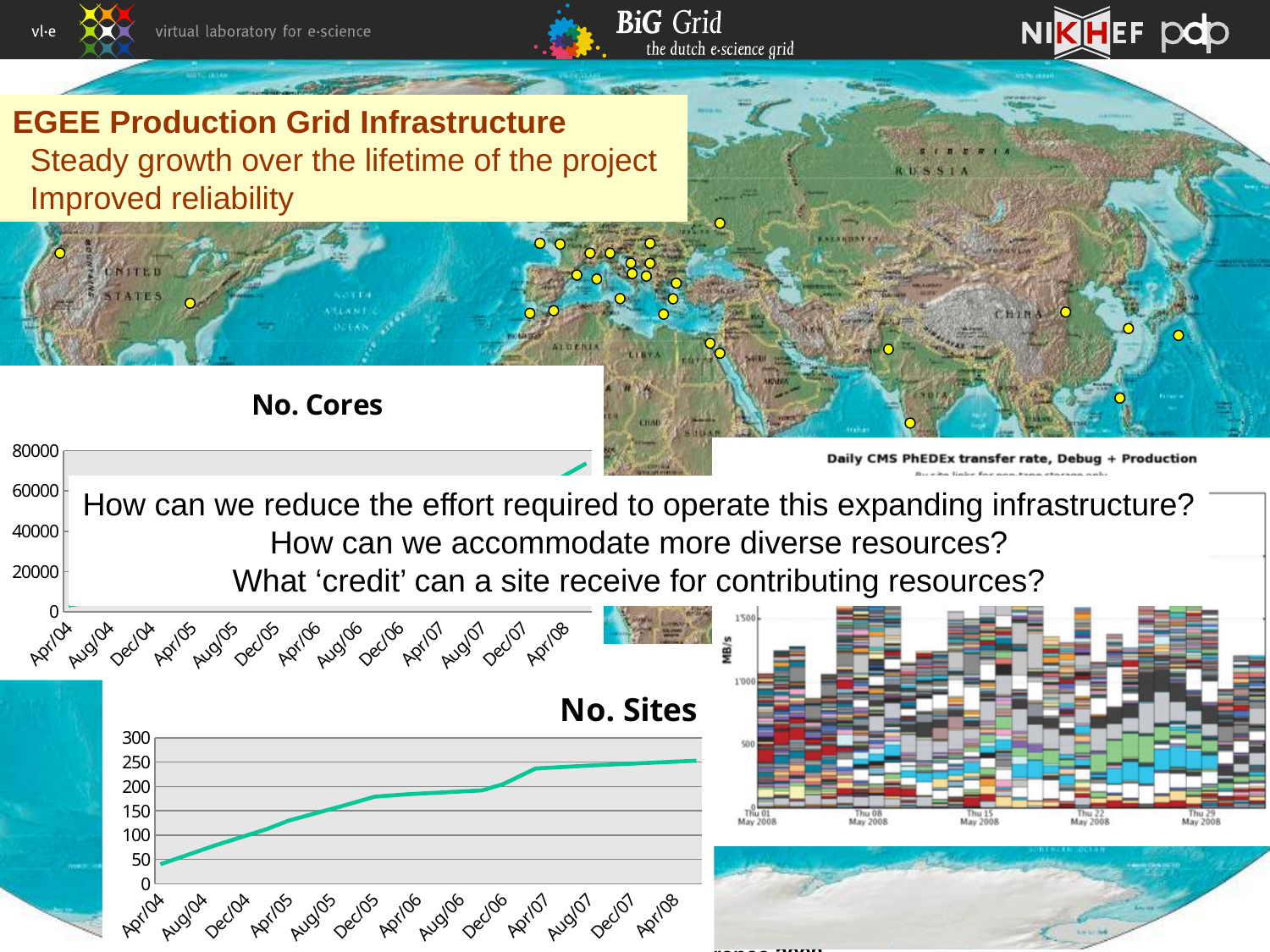
What is the maximum value shown on the y-axis of the 'No. Cores' chart? 80000 In the 'No. Sites' chart, is the value for Apr/07 greater or less than 200? greater In the 'No. Sites' chart, is the value for Dec/05 greater or less than 150? greater In the 'No. Sites' chart, which is larger, the value for Dec/06 or the value for Apr/07? Apr/07 In the 'No. Sites' chart, which x-axis point has the lowest value? Apr/04 In the 'No. Sites' chart, do the values rise or fall from Apr/04 to Apr/08? rise How many x-axis tick labels does the 'No. Sites' chart show? 13 What type of chart is the 'No. Sites' chart? line chart What type of chart is the 'Daily CMS PhEDEx transfer rate, Debug + Production' chart? bar chart In the 'No. Sites' chart, is the value for Aug/04 greater or less than 100? less In the 'No. Sites' chart, which x-axis point has the highest value? Apr/08